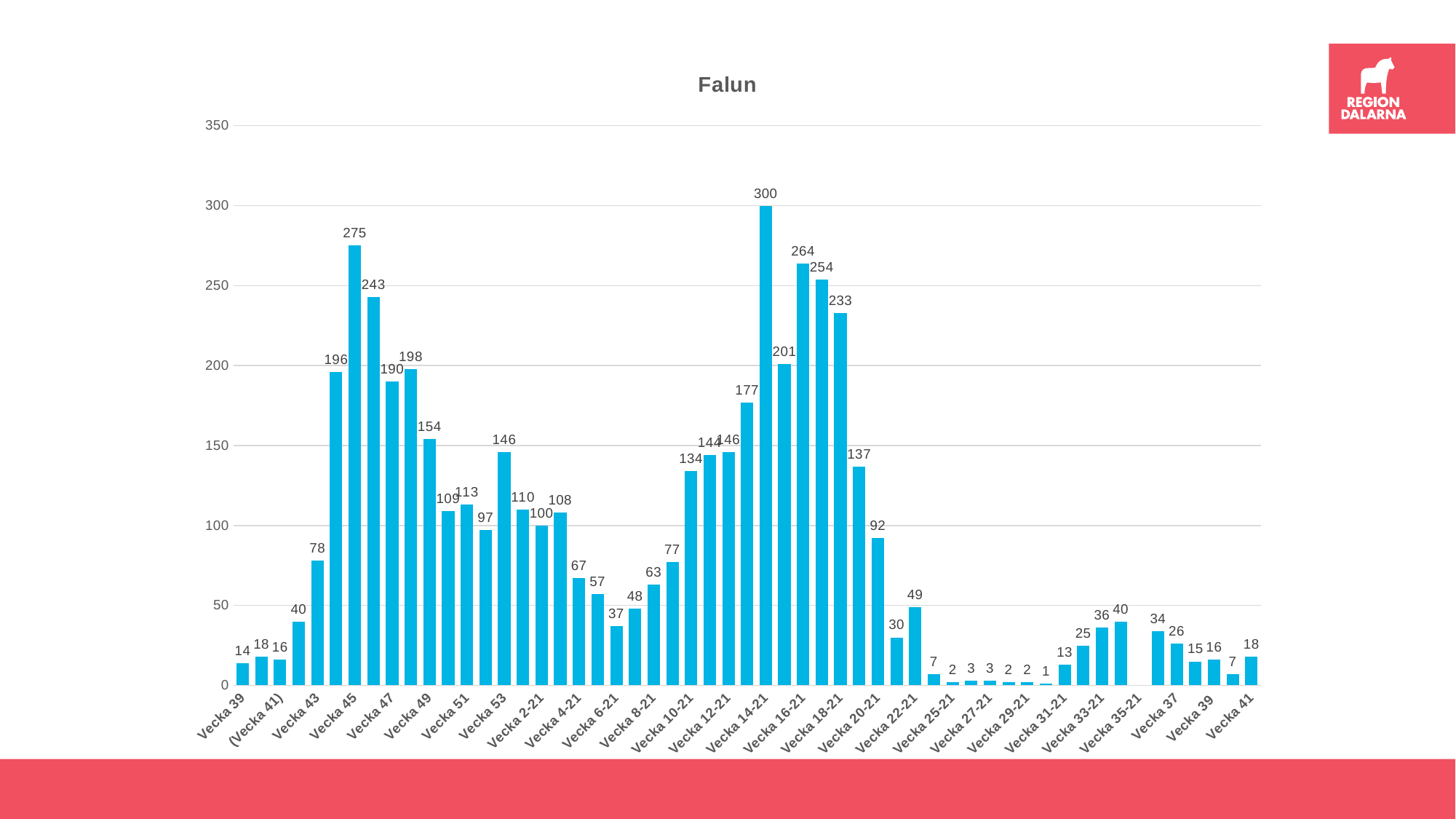
What is the value for Vecka 14-21? 300 What is the difference between the values for Vecka 45 and Vecka 43? 197 What is the value for Vecka 6-21? 37 What kind of chart is shown on the slide? bar chart What is the title of the chart? Falun Which is larger, the value for Vecka 45 or the value for Vecka 47? Vecka 45 Which week has the highest value in the chart? Vecka 14-21 What is the value for Vecka 18-21? 233 What is the value for Vecka 33-21? 36 What is the difference between the values for Vecka 16-21 and Vecka 18-21? 31 What is the value for Vecka 45? 275 Is the value for Vecka 20-21 greater or less than 100? less